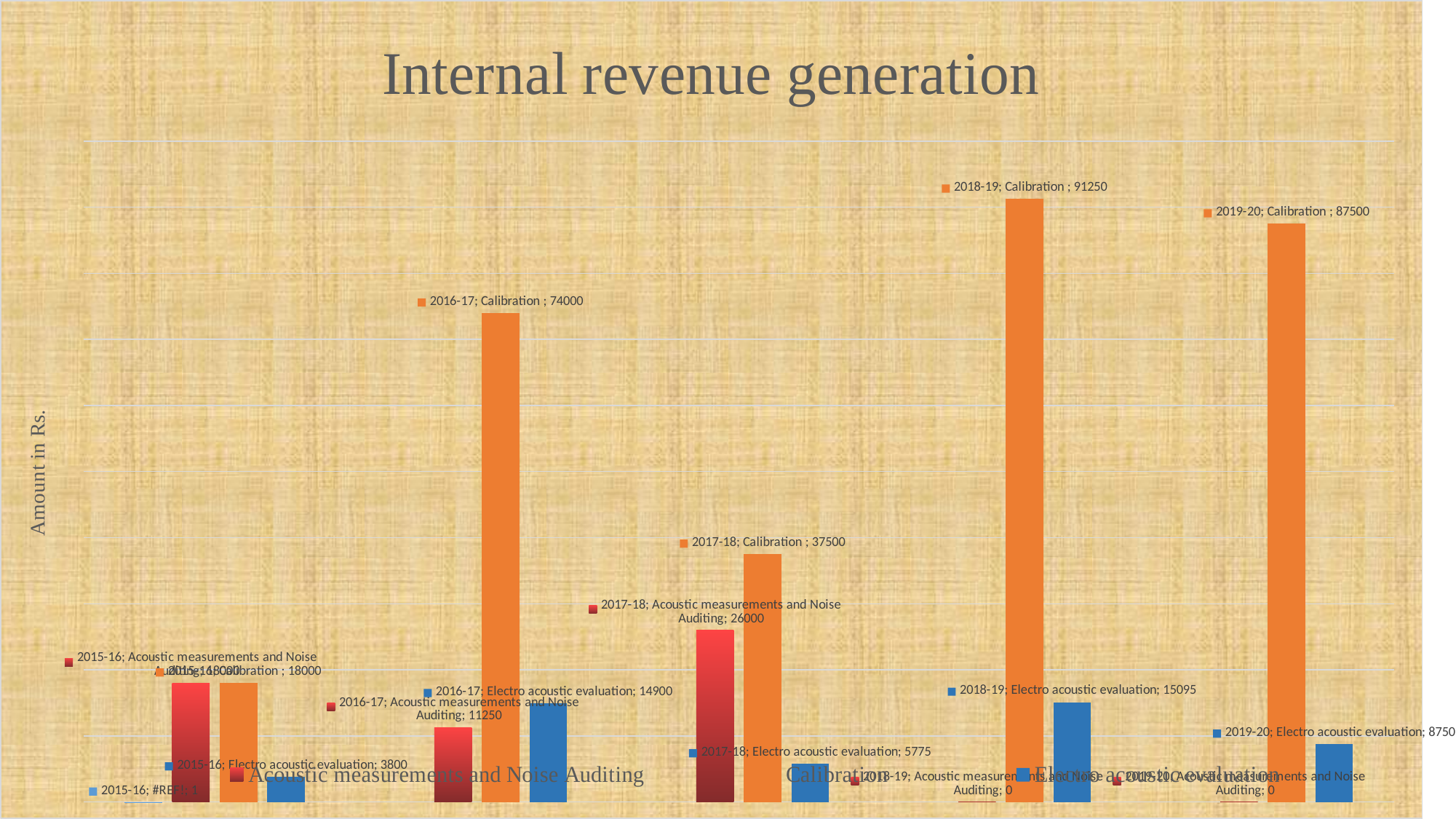
In which year is the Calibration value highest? 2018-19 What is the Electro acoustic evaluation value for 2016-17? 14900 What is the Acoustic measurements and Noise Auditing value for 2018-19? 0 What is the Acoustic measurements and Noise Auditing value for 2017-18? 26000 What is the Calibration value for 2018-19? 91250 What is the difference between the Calibration values for 2018-19 and 2019-20? 3750 Which is larger: the Acoustic measurements and Noise Auditing value for 2017-18 or for 2016-17? 2017-18 What kind of chart is shown on the slide? bar chart What is the difference between the Calibration and Electro acoustic evaluation values for 2017-18? 31725 What is the Electro acoustic evaluation value for 2019-20? 8750 What is the title of the chart? Internal revenue generation In which year is the Calibration value lowest? 2015-16